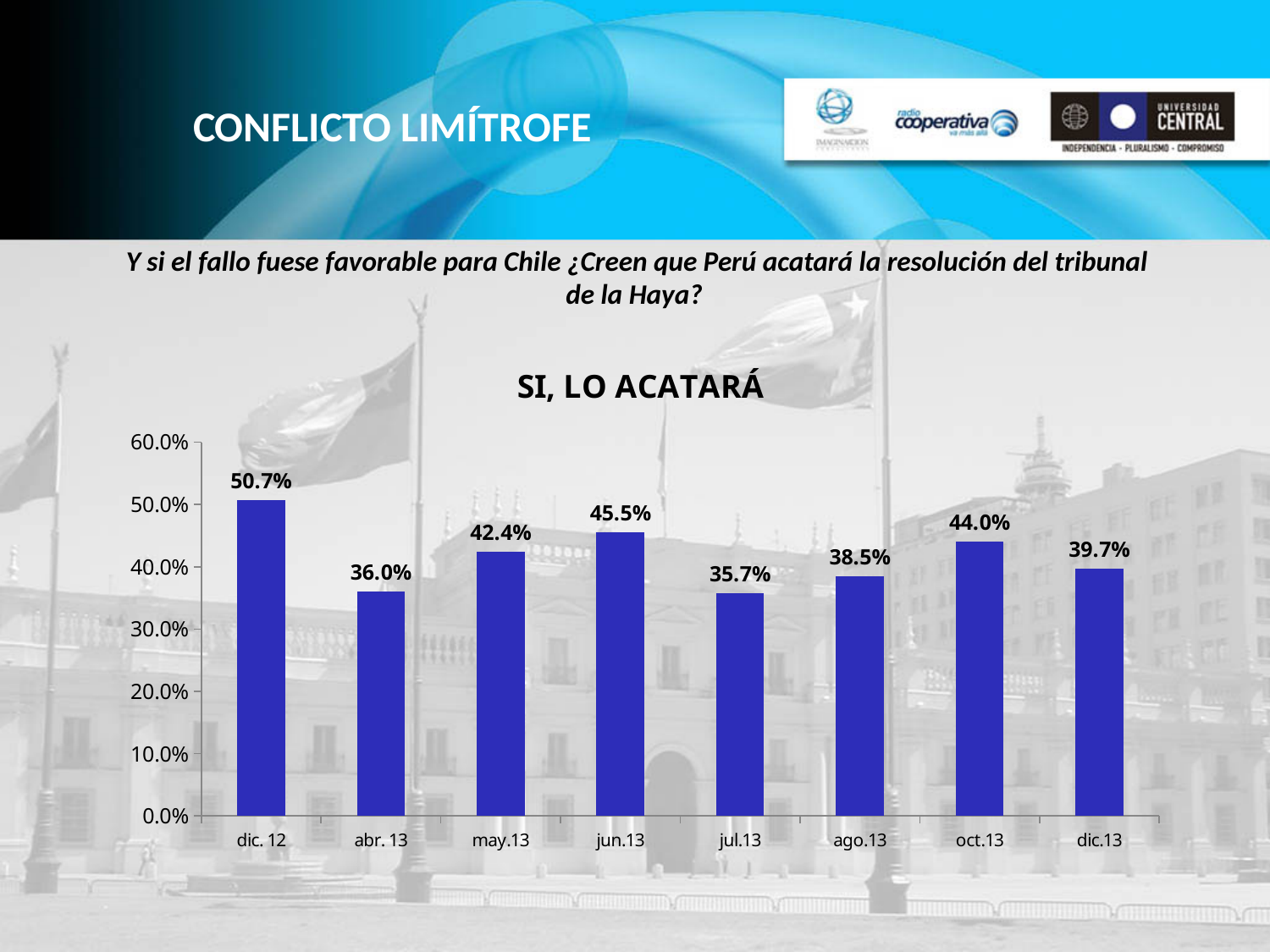
What is the value for oct.13? 44.0% What kind of chart is shown on the slide? bar chart Which category has the lowest value? jul.13 Is the value for jun.13 greater or less than 40.0%? greater What is the title of the chart? SI, LO ACATARÁ What is the value for jul.13? 35.7% What is the difference between the values for jun.13 and may.13? 3.1% What is the difference between the values for dic. 12 and dic.13? 11.0% What is the value for dic. 12? 50.7% Which is larger, the value for abr. 13 or the value for ago.13? ago.13 Which category has the highest value? dic. 12 How many categories are shown on the x axis? 8